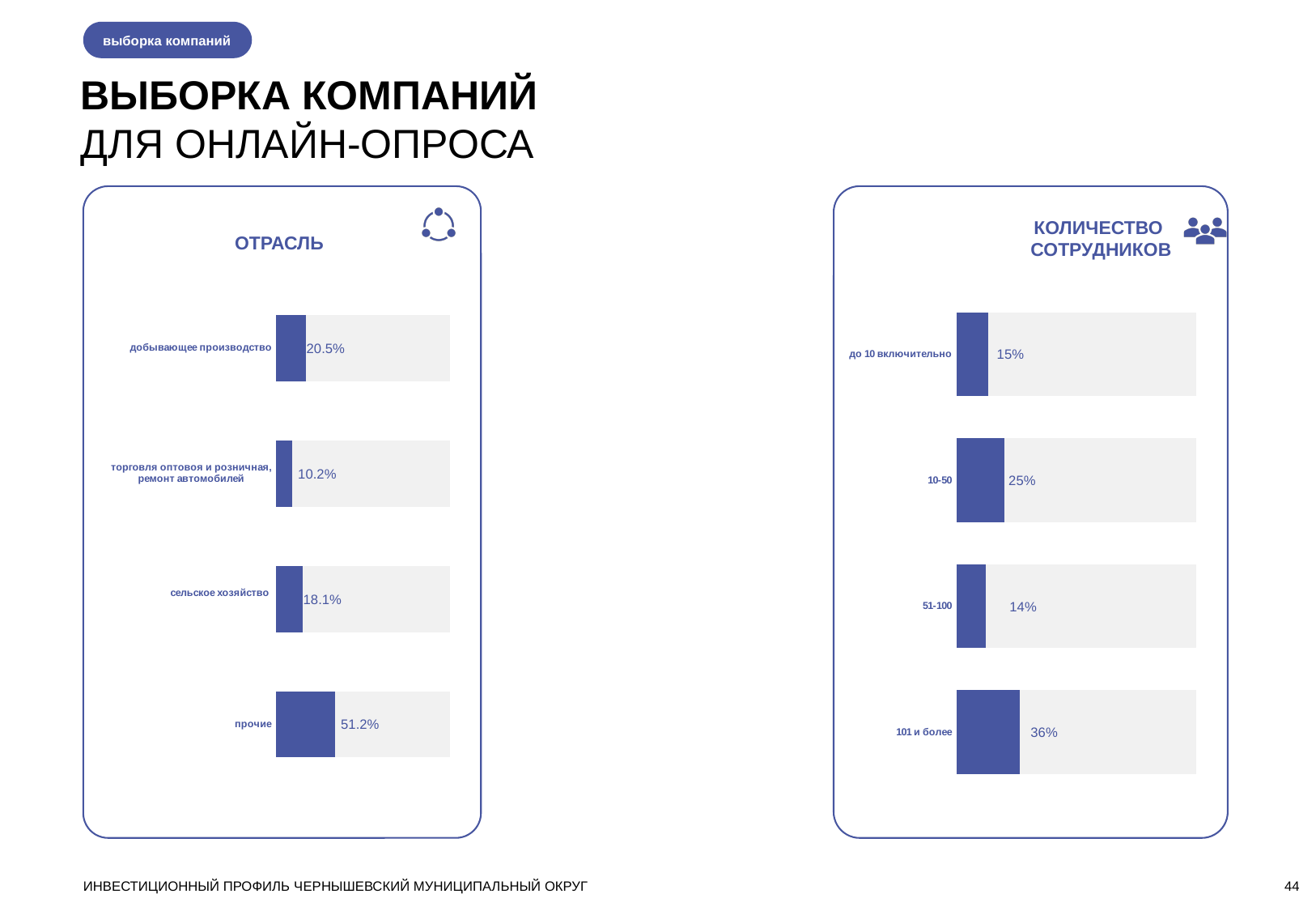
In the "КОЛИЧЕСТВО СОТРУДНИКОВ" chart, which category has the lowest value? 51-100 In the "ОТРАСЛЬ" chart, what is the difference between "прочие" and "добывающее производство"? 30.7% In the "ОТРАСЛЬ" chart, what is the value for "добывающее производство"? 20.5% In the "ОТРАСЛЬ" chart, what is the value for "сельское хозяйство"? 18.1% In the "ОТРАСЛЬ" chart, which category has the lowest value? торговля оптовоя и розничная, ремонт автомобилей In the "ОТРАСЛЬ" chart, how many categories are shown? 4 In the "КОЛИЧЕСТВО СОТРУДНИКОВ" chart, which is larger: "до 10 включительно" or "10-50"? 10-50 In the "ОТРАСЛЬ" chart, which category has the highest value? прочие In the "КОЛИЧЕСТВО СОТРУДНИКОВ" chart, what is the difference between "101 и более" and "51-100"? 22% In the "КОЛИЧЕСТВО СОТРУДНИКОВ" chart, what is the value for "101 и более"? 36% What type of chart is the "КОЛИЧЕСТВО СОТРУДНИКОВ" chart? Bar chart In the "КОЛИЧЕСТВО СОТРУДНИКОВ" chart, what is the value for "10-50"? 25%